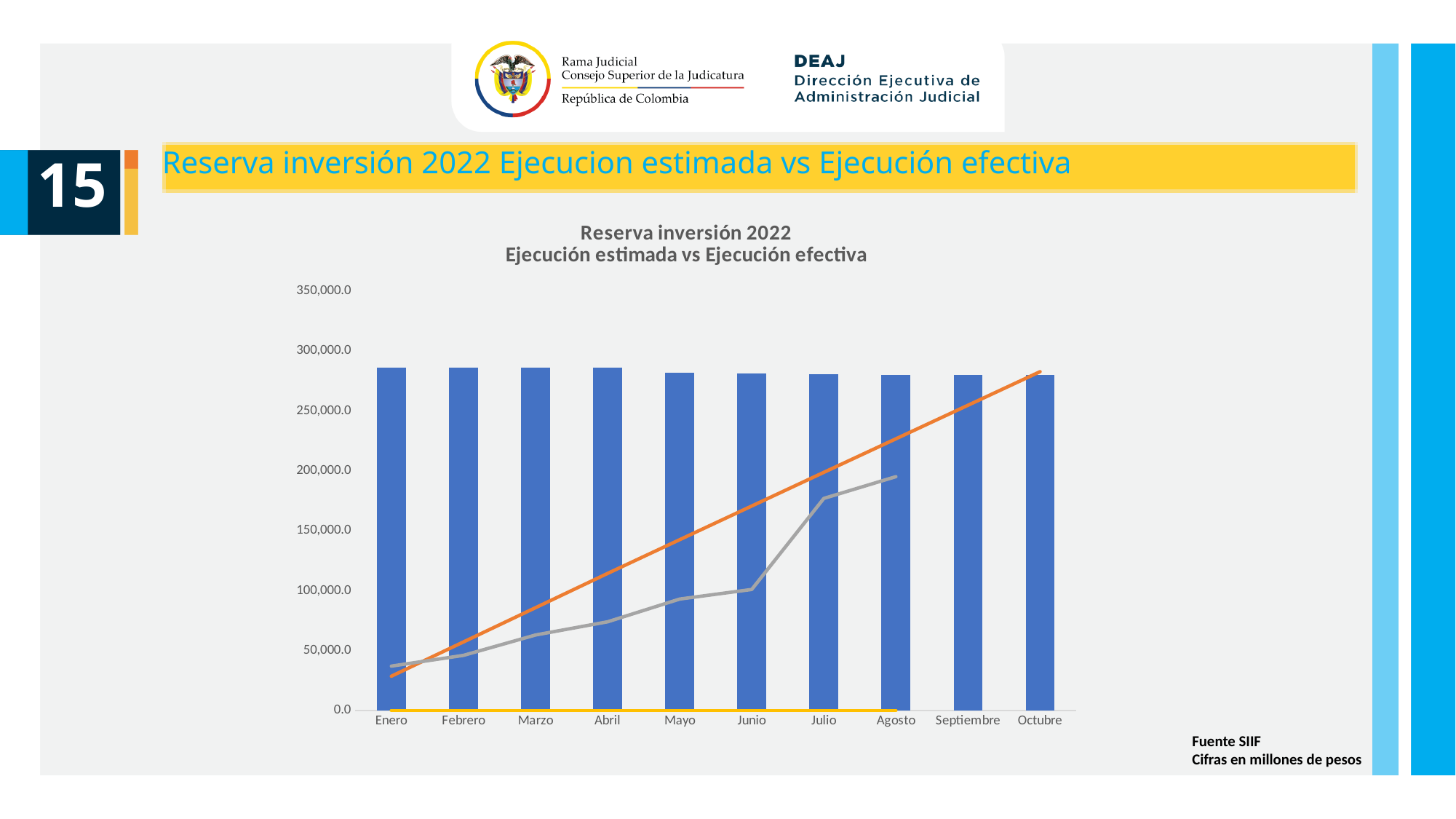
What is the highest value shown on the vertical axis of the chart? 350,000.0 Is the value of the gray line at Agosto greater or less than 200,000? less Is the value of the blue bar for Octubre greater or less than 300,000? less In which month does the gray line end? Agosto What is the title of the chart? Reserva inversión 2022 Ejecución estimada vs Ejecución efectiva Is the value of the orange line at Enero greater or less than 50,000? less What kind of chart is shown on the slide? A bar chart combined with line series Does the orange line rise or fall from Enero to Octubre? rises How many months are shown on the x axis of the chart? 10